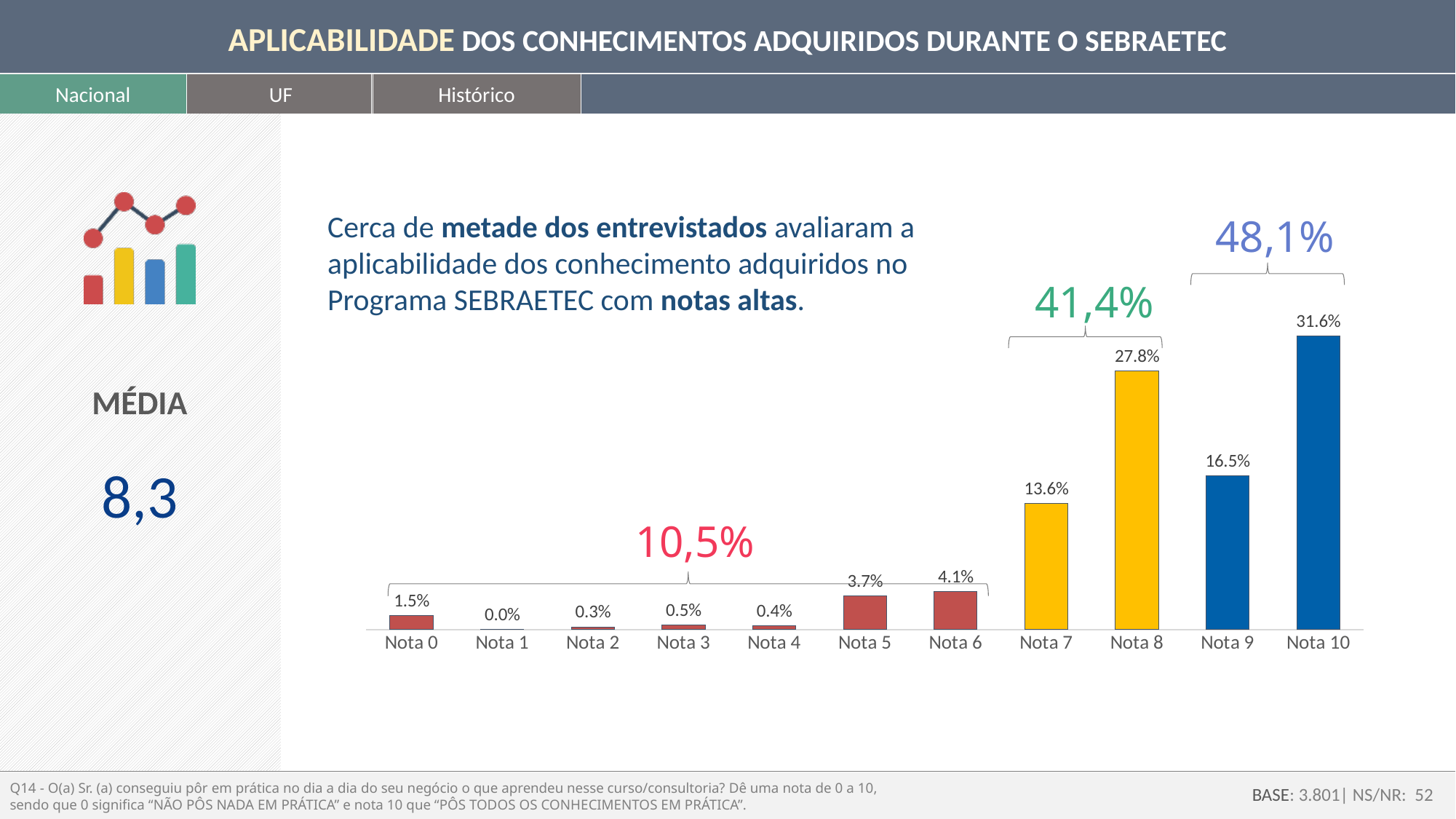
What kind of chart is shown on the slide? Bar chart What is the difference between the values for Nota 10 and Nota 8? 3.8% Which is larger, the value for Nota 8 or the value for Nota 9? Nota 8 What is the difference between the values for Nota 9 and Nota 7? 2.9% What is the value for Nota 5? 3.7% Which category has the lowest value? Nota 1 What combined percentage is shown above the bracket covering Nota 0 to Nota 6? 10,5% How many categories are shown on the x axis? 11 What is the value for Nota 10? 31.6% What is the value for Nota 8? 27.8% What combined percentage is shown above the bracket covering Nota 9 and Nota 10? 48,1% Which category has the highest value? Nota 10